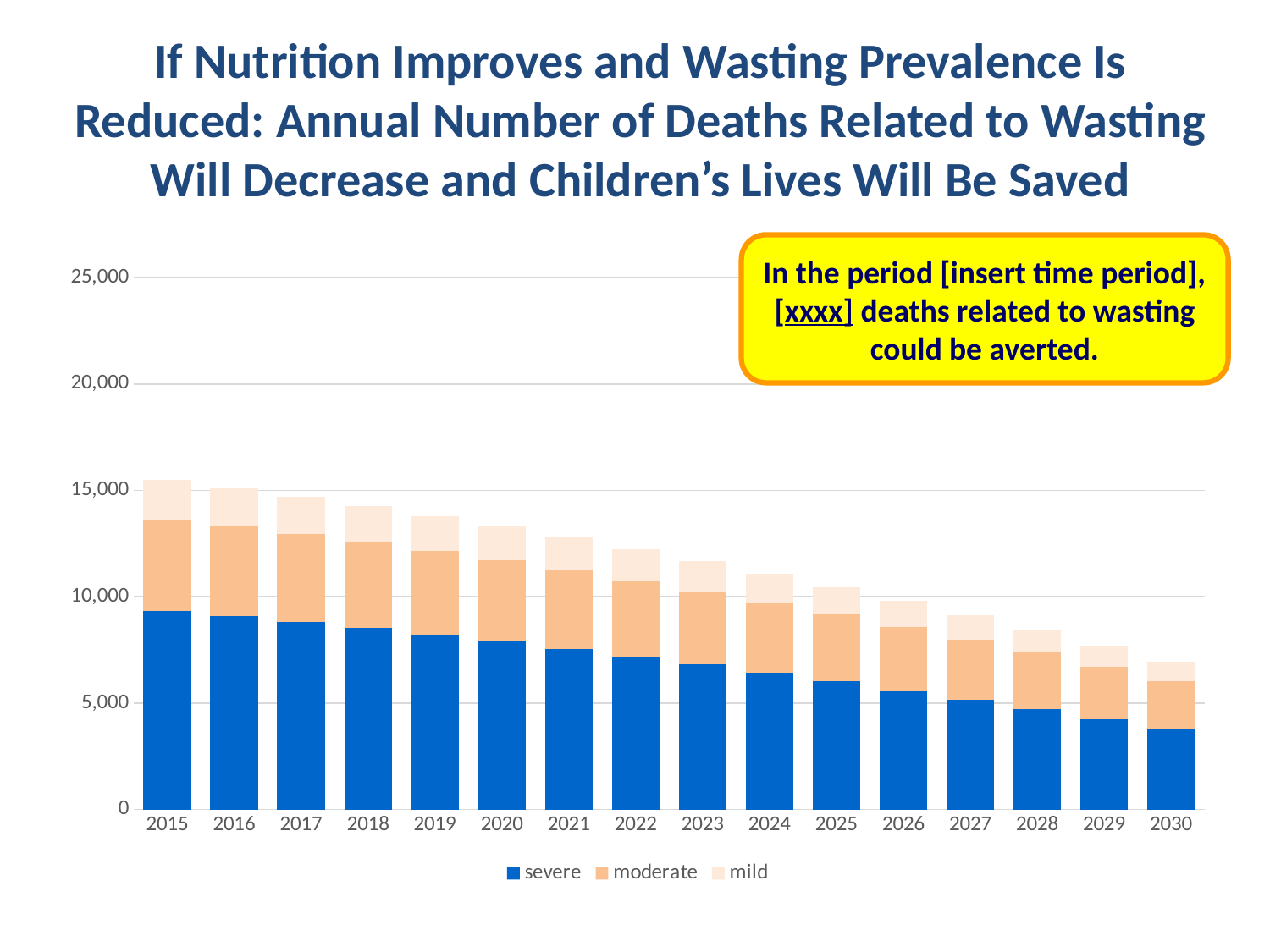
Is the total bar for 2028 greater or less than 10,000? less Which is larger, the severe value for 2015 or the severe value for 2030? 2015 Which year has the highest total number of deaths? 2015 Do the total deaths rise or fall from 2015 to 2030? fall What kind of chart is shown on the slide? stacked bar chart Is the severe value for 2030 greater or less than 5,000? less Is the severe value for 2015 greater or less than 10,000? less How many years are shown along the x axis? 16 Which year has the lowest total number of deaths? 2030 How many series does the legend list? 3 Which series is shown in dark blue? severe